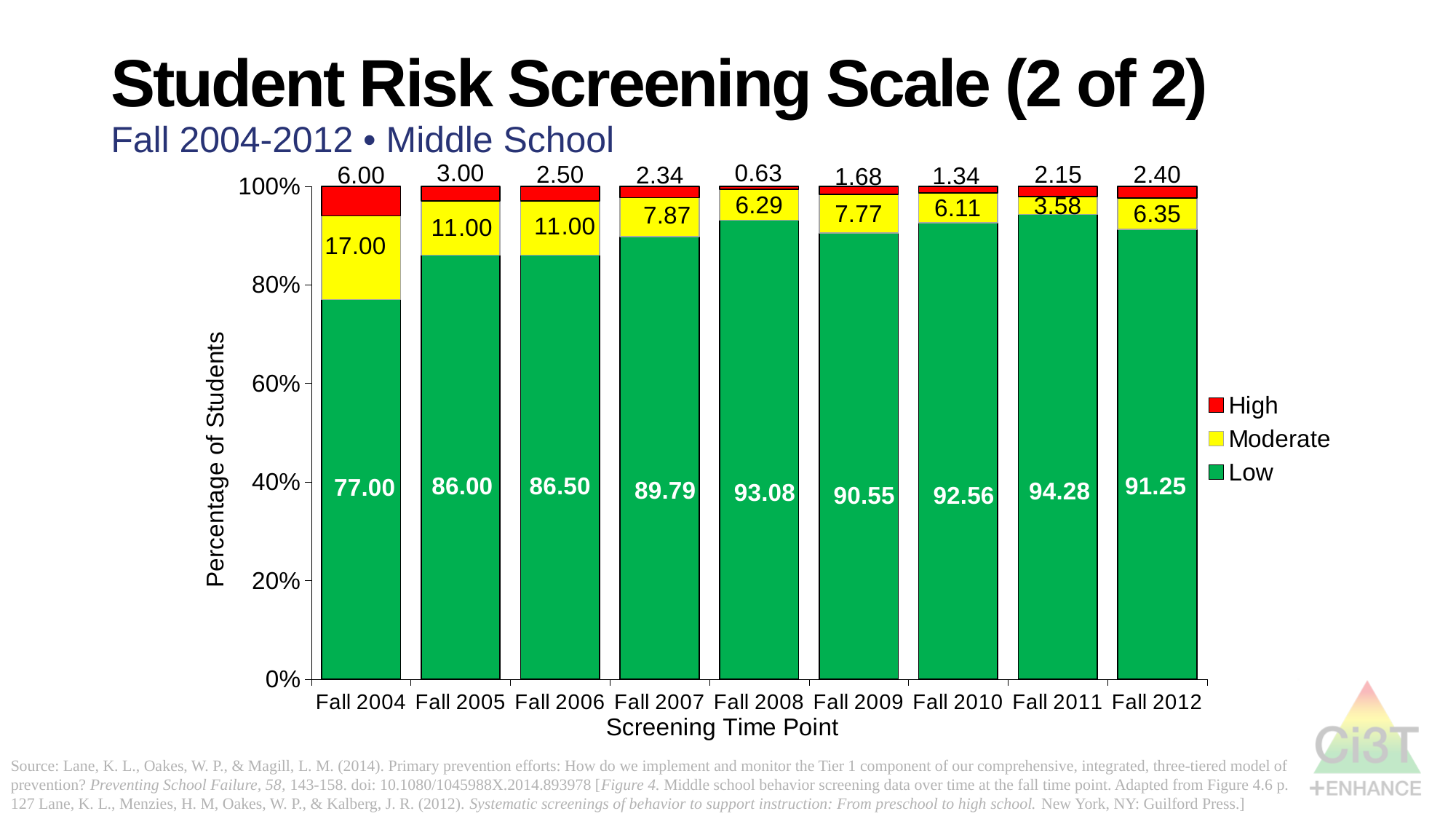
What is the High value for Fall 2008? 0.63 What kind of chart is shown on the slide? Stacked bar chart Which screening time point has the highest Low value? Fall 2011 Which screening time point has the lowest Low value? Fall 2004 Does the Low value rise or fall from Fall 2004 to Fall 2007? Rise What is the Moderate value for Fall 2004? 17.00 Which screening time point has the lowest High value? Fall 2008 How many screening time points are shown on the x axis? 9 How many series does the legend list? 3 Which is larger, the Moderate value for Fall 2009 or for Fall 2010? Fall 2009 What is the Low value for Fall 2011? 94.28 What is the difference between the Low value for Fall 2012 and the Low value for Fall 2004? 14.25